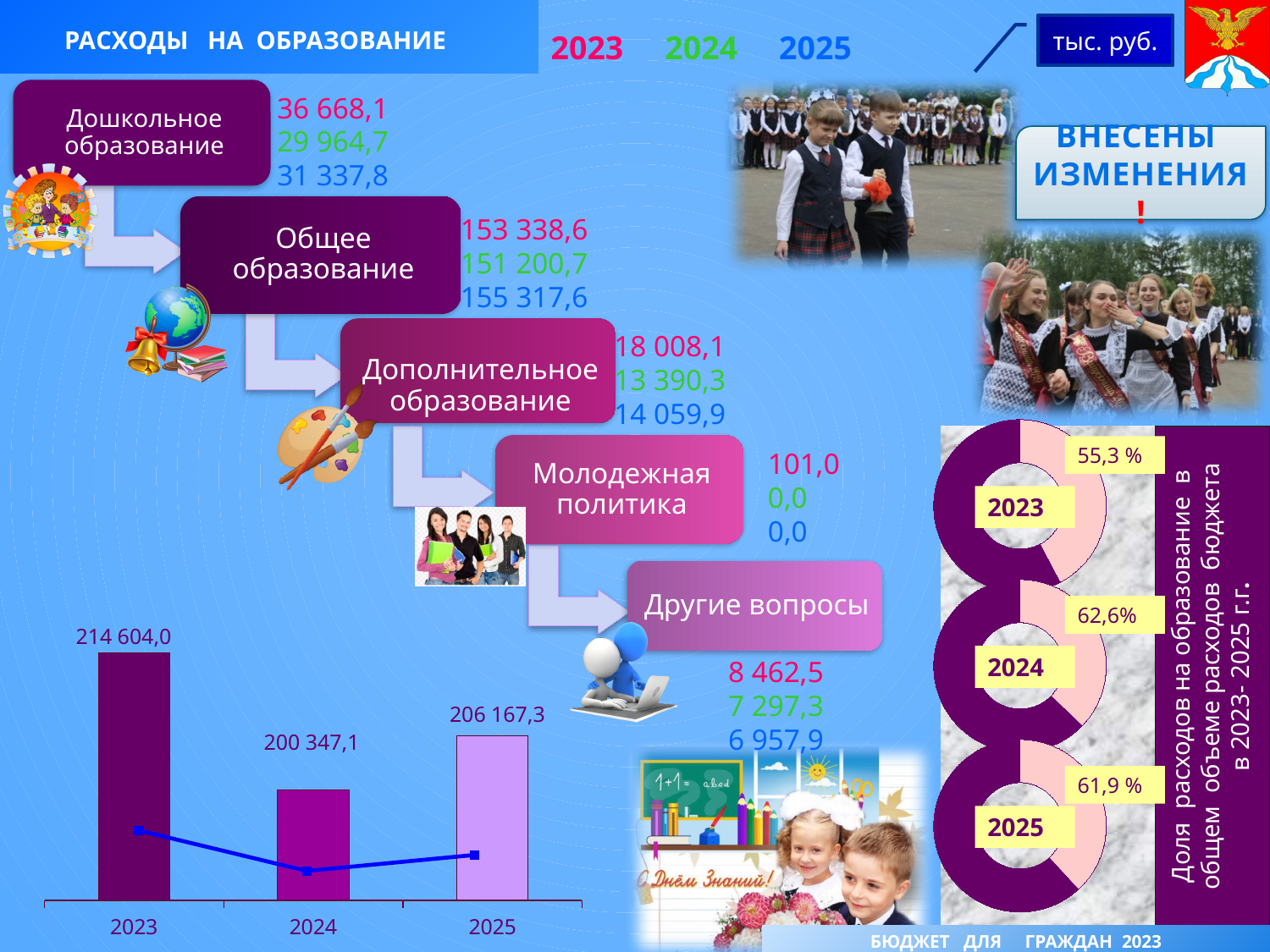
On the circular share graphic on the right, what share of budget expenditure goes to education in 2024? 62,6% On the bar chart at the bottom left, what is the value for 2023? 214 604,0 On the bar chart at the bottom left, which year has the highest value? 2023 What kind of chart is shown at the bottom left of the slide? bar chart On the bar chart at the bottom left, what is the value for 2024? 200 347,1 On the bar chart at the bottom left, what is the difference between the 2023 and 2024 values? 14 256,9 How many years (categories) are shown on the bar chart at the bottom left? 3 On the bar chart at the bottom left, what is the difference between the 2025 and 2024 values? 5 820,2 On the bar chart at the bottom left, what is the value for 2025? 206 167,3 On the bar chart at the bottom left, which is larger: the value for 2025 or the value for 2024? 2025 On the bar chart at the bottom left, do the values rise or fall from 2023 to 2024? fall On the bar chart at the bottom left, which year has the lowest value? 2024